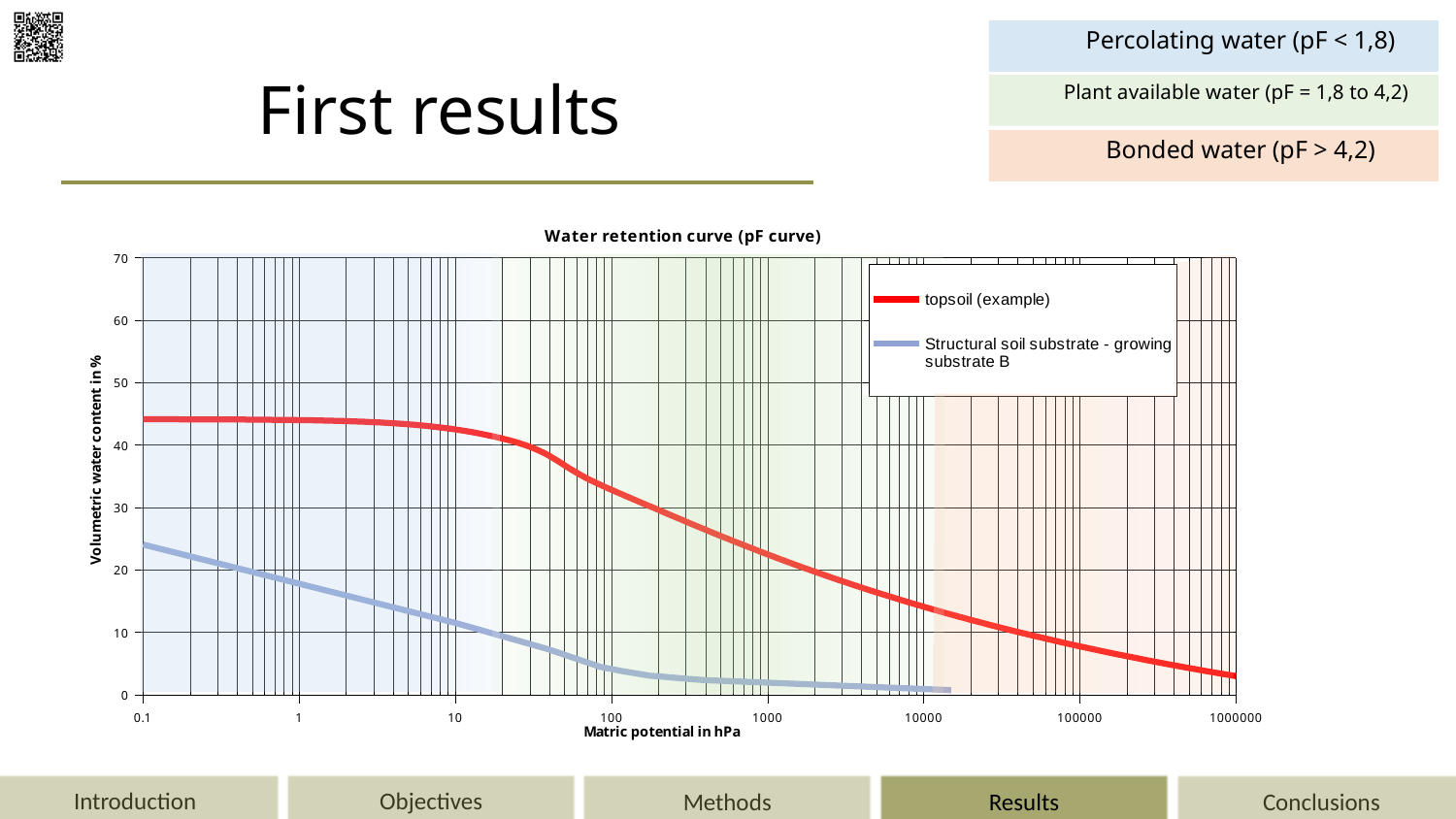
Does the volumetric water content of the topsoil (example) rise or fall as matric potential increases along the x axis? fall What kind of chart is shown on the slide? line chart Is the volumetric water content of the topsoil (example) at 100000 hPa greater or less than 10? less Does the volumetric water content of Structural soil substrate - growing substrate B rise or fall as matric potential increases? fall At 1000 hPa, which series has the higher volumetric water content: topsoil (example) or Structural soil substrate - growing substrate B? topsoil (example) How many series does the chart legend list? 2 Is the volumetric water content of Structural soil substrate - growing substrate B at 100 hPa greater or less than 10? less Which series is drawn in red? topsoil (example) What is the label of the y axis? Volumetric water content in % Is the volumetric water content of the topsoil (example) at 0.1 hPa greater or less than 40? greater What is the title of the chart? Water retention curve (pF curve)